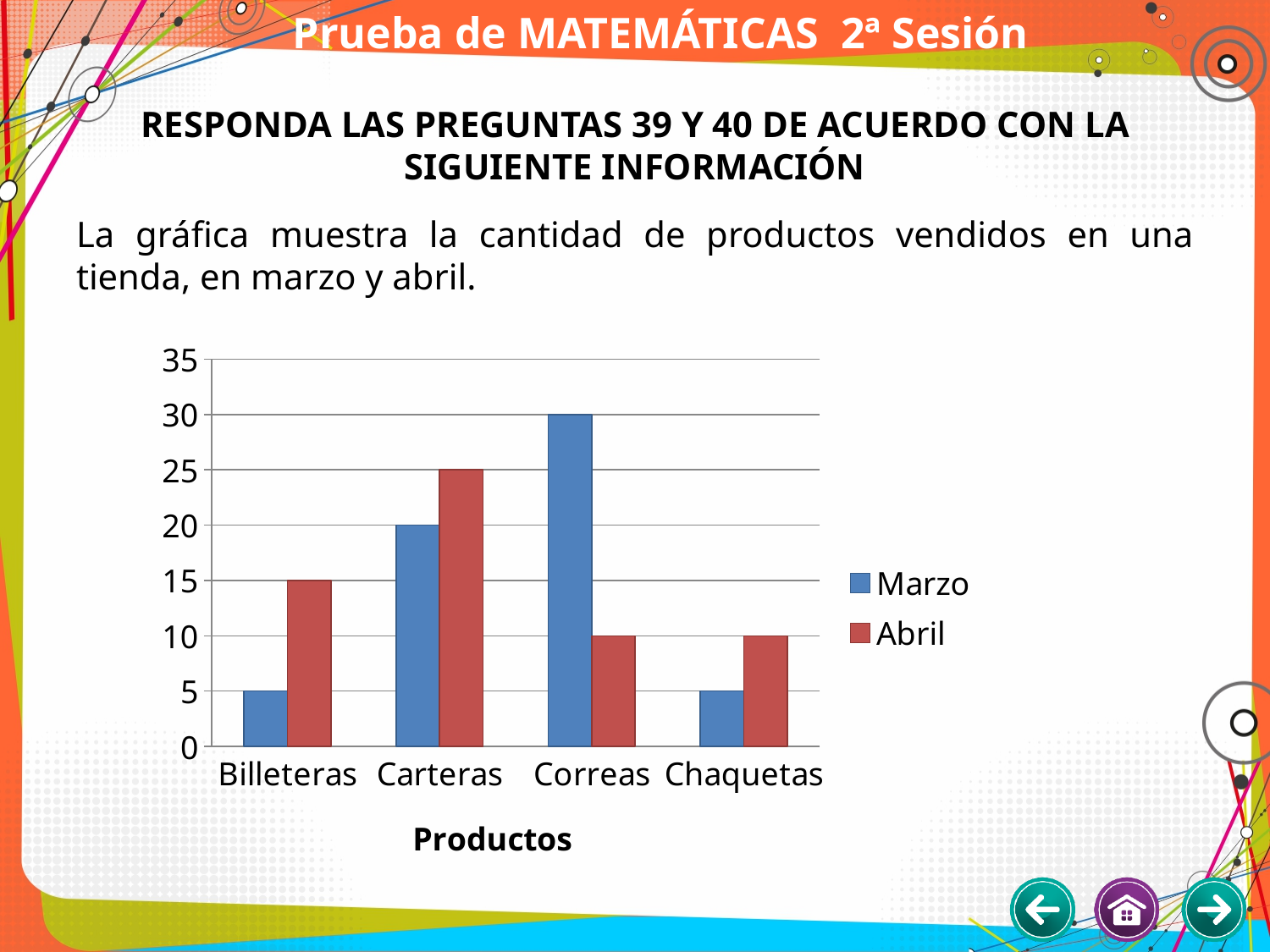
What is the value for Billeteras in Marzo? 5 Which product has the highest value in Marzo? Correas What is the value for Carteras in Abril? 25 What is the value for Correas in Marzo? 30 What is the label of the x axis? Productos What is the difference between the Marzo and Abril values for Correas? 20 How many series does the legend list? 2 Which is larger for Billeteras, the Marzo value or the Abril value? Abril Is the value for Carteras in Marzo greater or less than 15? greater How many product categories are shown on the x axis? 4 What kind of chart is shown on the slide? bar chart